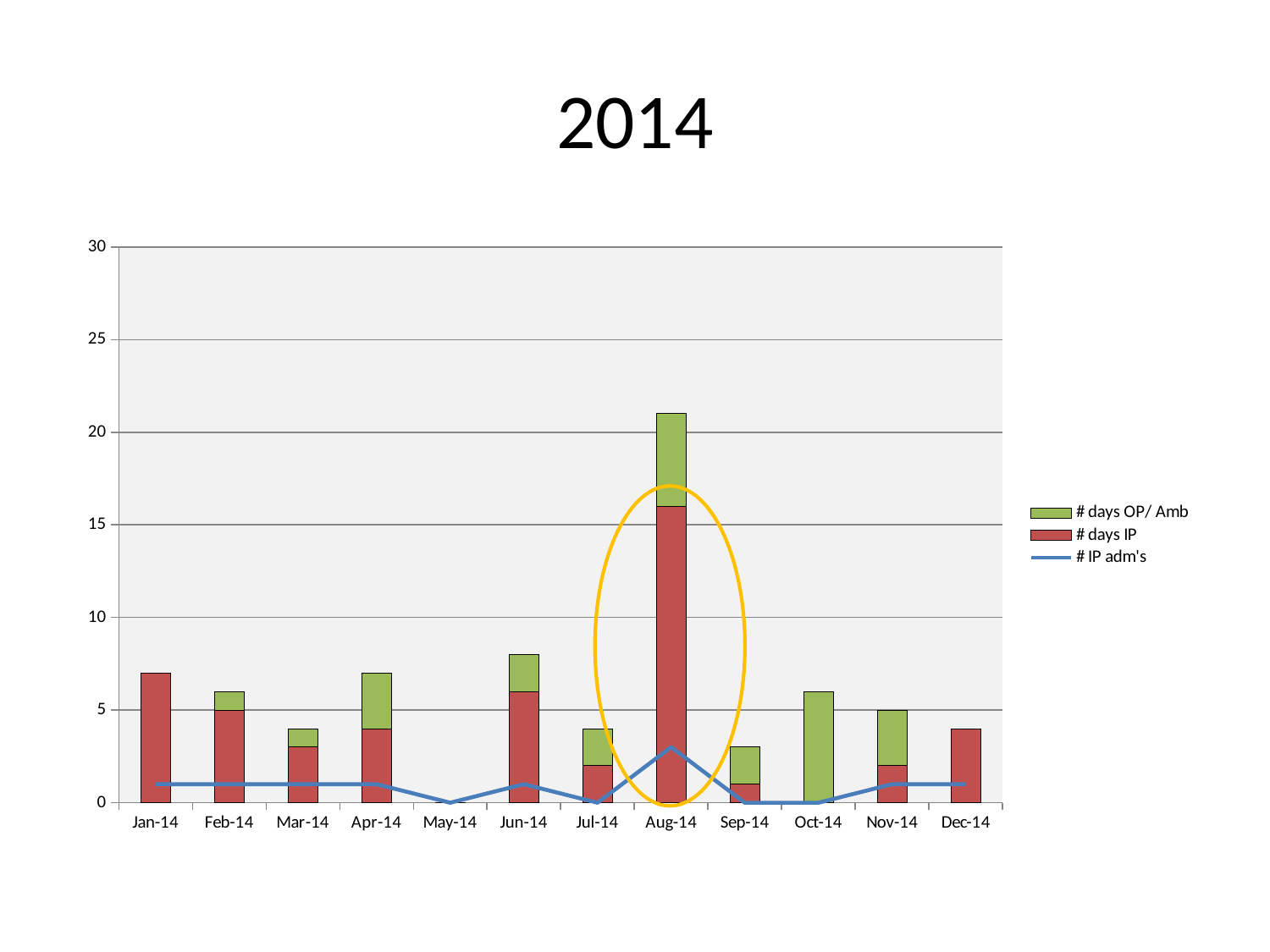
Which month's bar is highlighted with a yellow oval? Aug-14 What kind of chart is shown on the slide? combination bar and line chart How many series does the legend list? 3 How many months are shown on the x axis? 12 What is the # IP adm's value for May-14? 0 Which month has the tallest stacked bar? Aug-14 What is the title of the slide? 2014 Is the # days IP value for Aug-14 greater or less than 10? greater Which month has no bar at all? May-14 Is the total stacked bar for Jan-14 greater or less than 10? less Is the total stacked bar for Aug-14 greater or less than 15? greater Which has the taller stacked bar, Mar-14 or Apr-14? Apr-14